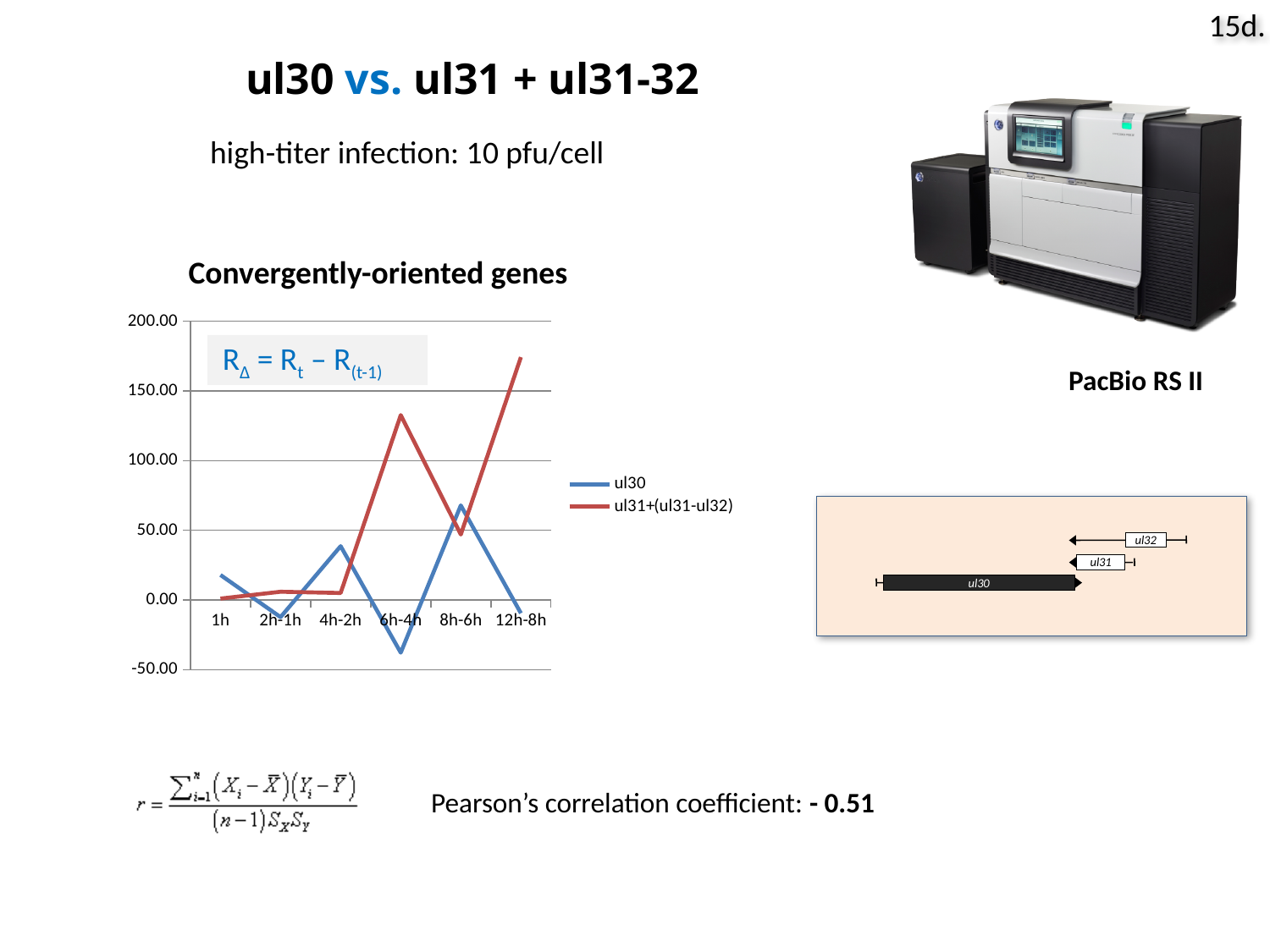
At 6h-4h, which series has the higher value, ul30 or ul31+(ul31-ul32)? ul31+(ul31-ul32) Is the value of ul31+(ul31-ul32) at 6h-4h greater or less than 100.00? greater For the ul30 series, at which x-axis category is the value highest? 8h-6h How many series does the legend of the chart list? 2 For the ul31+(ul31-ul32) series, at which x-axis category is the value highest? 12h-8h How many categories are shown on the x axis of the chart? 6 Is the value of ul31+(ul31-ul32) at 12h-8h greater or less than 150.00? greater For the ul30 series, at which x-axis category is the value lowest? 6h-4h What kind of chart is shown under the title "Convergently-oriented genes"? line chart At 8h-6h, which series has the higher value, ul30 or ul31+(ul31-ul32)? ul30 Is the value of ul30 at 6h-4h greater or less than 0.00? less What colour is the line for the ul30 series? blue